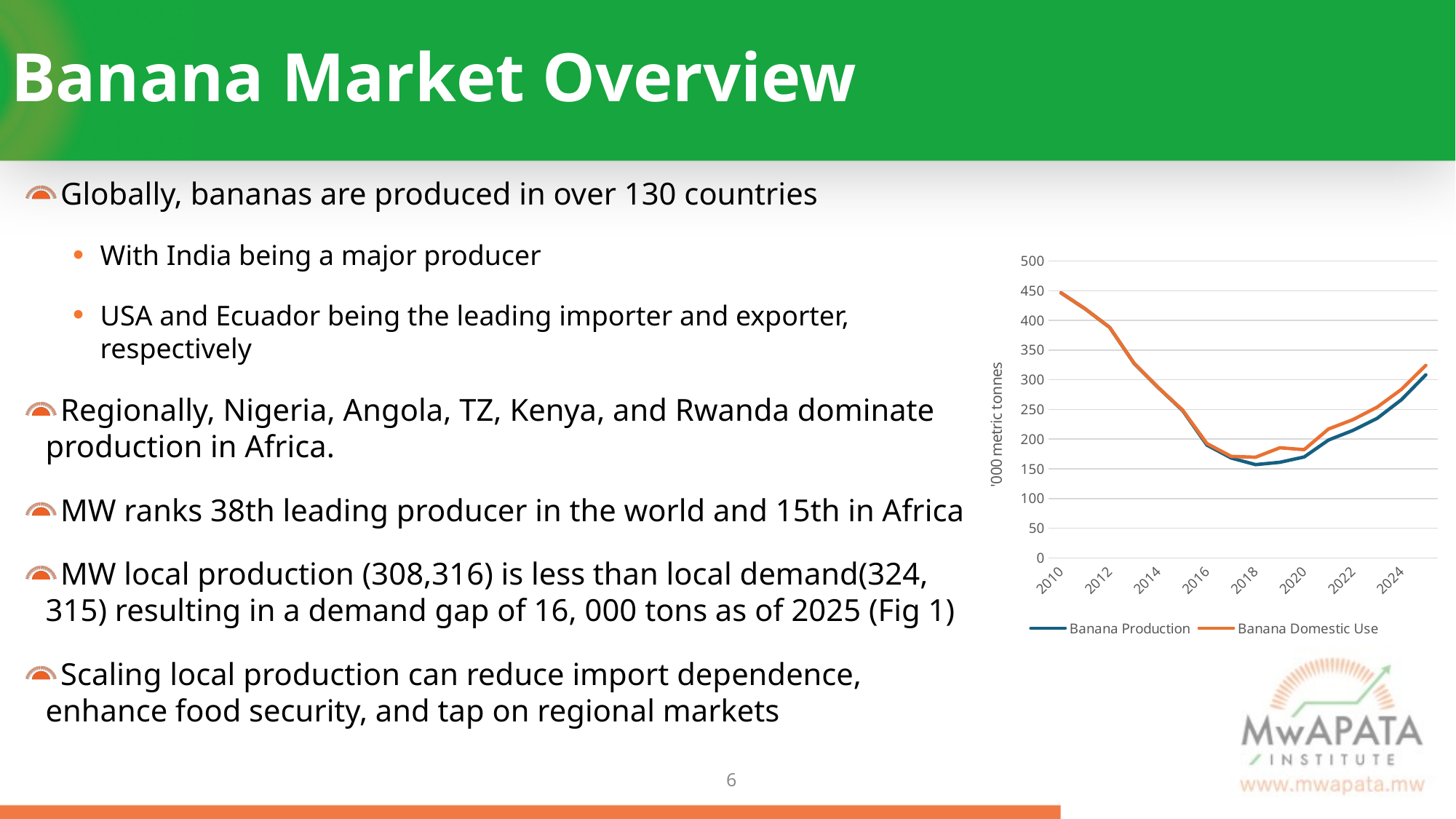
Is the Banana Production value in 2018 greater or less than 200? less Does Banana Domestic Use rise or fall between 2020 and 2024? rise Does Banana Production rise or fall between 2010 and 2018? fall Is the Banana Domestic Use value in 2024 greater or less than 200? greater What kind of chart is shown on the slide? line chart How many series does the chart's legend list? 2 In 2022, which series has the higher value, Banana Production or Banana Domestic Use? Banana Domestic Use Is the Banana Production value in 2010 greater or less than 400? greater What is the label on the chart's vertical axis? '000 metric tonnes In which year shown on the x axis is Banana Production at its highest? 2010 What are the two series named in the chart's legend? Banana Production and Banana Domestic Use